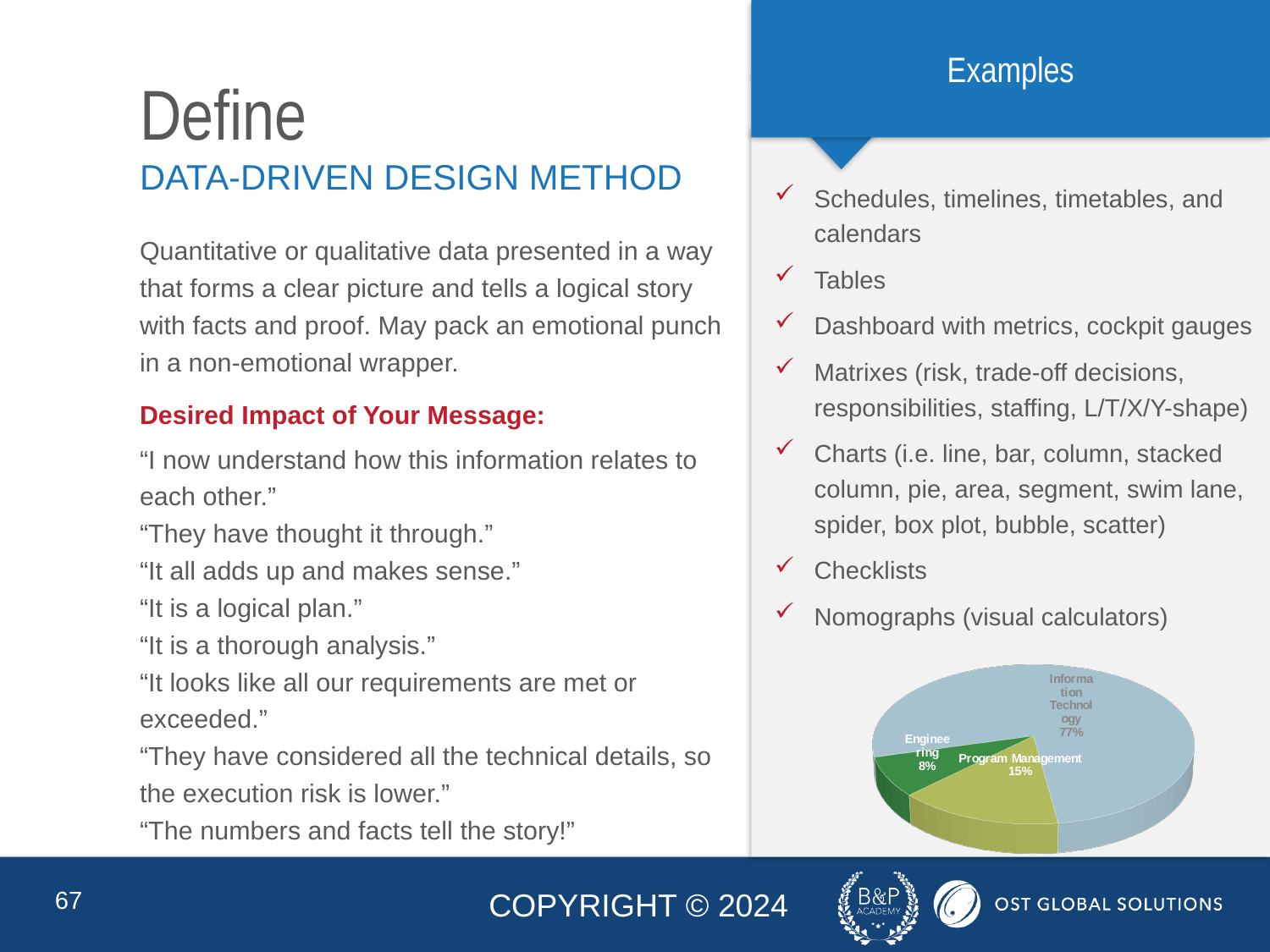
In the pie chart, what is the difference in percentage points between Program Management and Engineering? 7 How many slices does the pie chart have? 3 In the pie chart, what is the difference in percentage points between Information Technology and Program Management? 62 In the pie chart, what is the combined share of Program Management and Engineering? 23% What share of the pie chart is Engineering? 8% Does the pie chart have a legend? No Which slice of the pie chart is the smallest? Engineering What share of the pie chart is Program Management? 15% What kind of chart is shown at the bottom right of the slide? pie chart In the pie chart, which is larger: Program Management or Engineering? Program Management What share of the pie chart is Information Technology? 77% Which slice of the pie chart is the largest? Information Technology